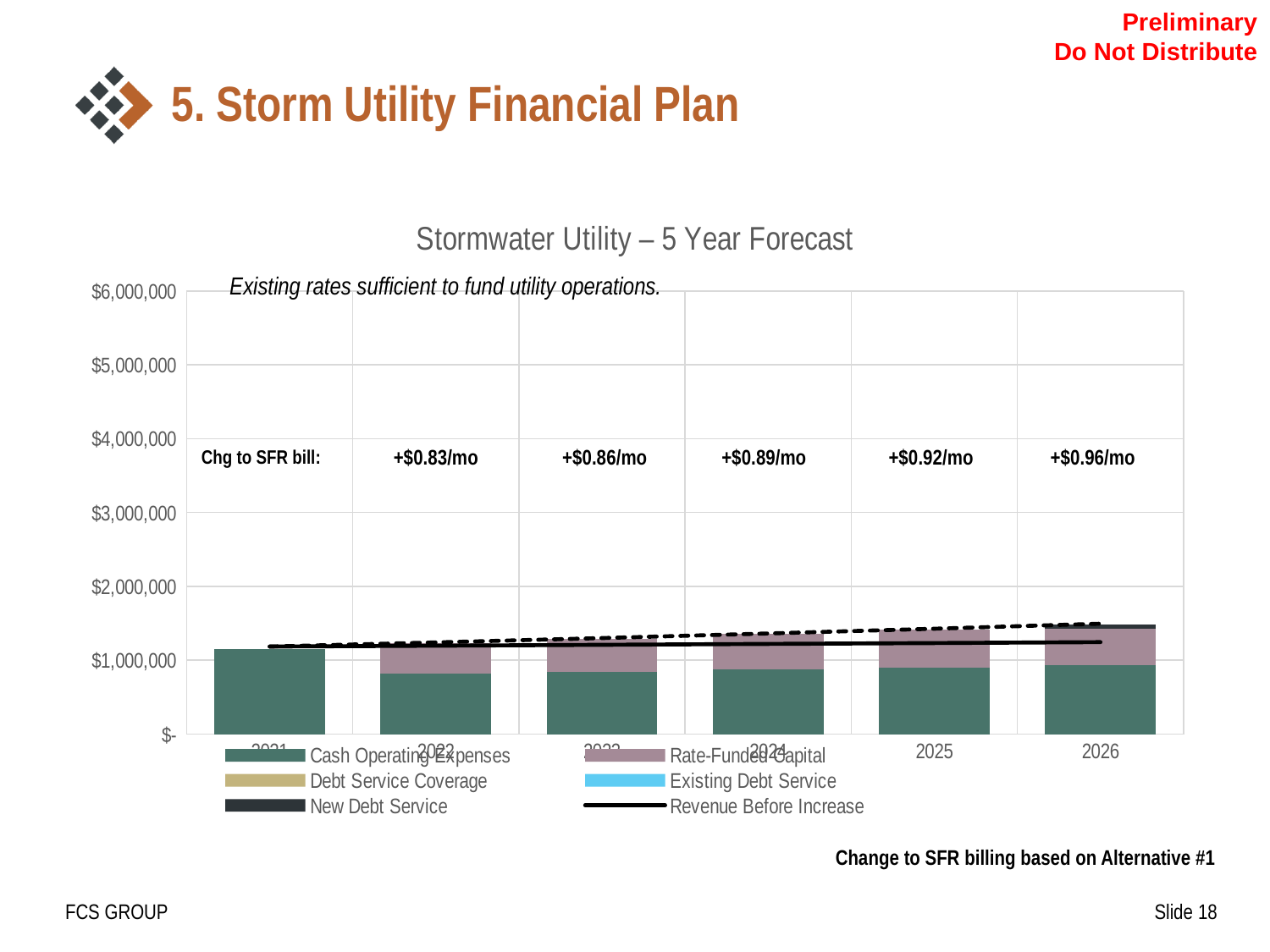
Is the Cash Operating Expenses value larger in 2021 or in 2022? 2021 What change to the SFR bill is shown for 2022? +$0.83/mo Do the total stacked bars rise or fall from 2022 to 2026? rise Is the Cash Operating Expenses value for 2022 greater or less than $1,000,000? less What is the title of the chart? Stormwater Utility – 5 Year Forecast What change to the SFR bill is shown for 2024? +$0.89/mo How many series does the chart legend list? 6 How many years are shown along the x axis of the chart? 6 Is the total stacked bar for 2026 greater or less than $2,000,000? less What kind of chart is shown on the slide? combination bar and line chart What change to the SFR bill is shown for 2026? +$0.96/mo Which year shows the largest change to the SFR bill? 2026